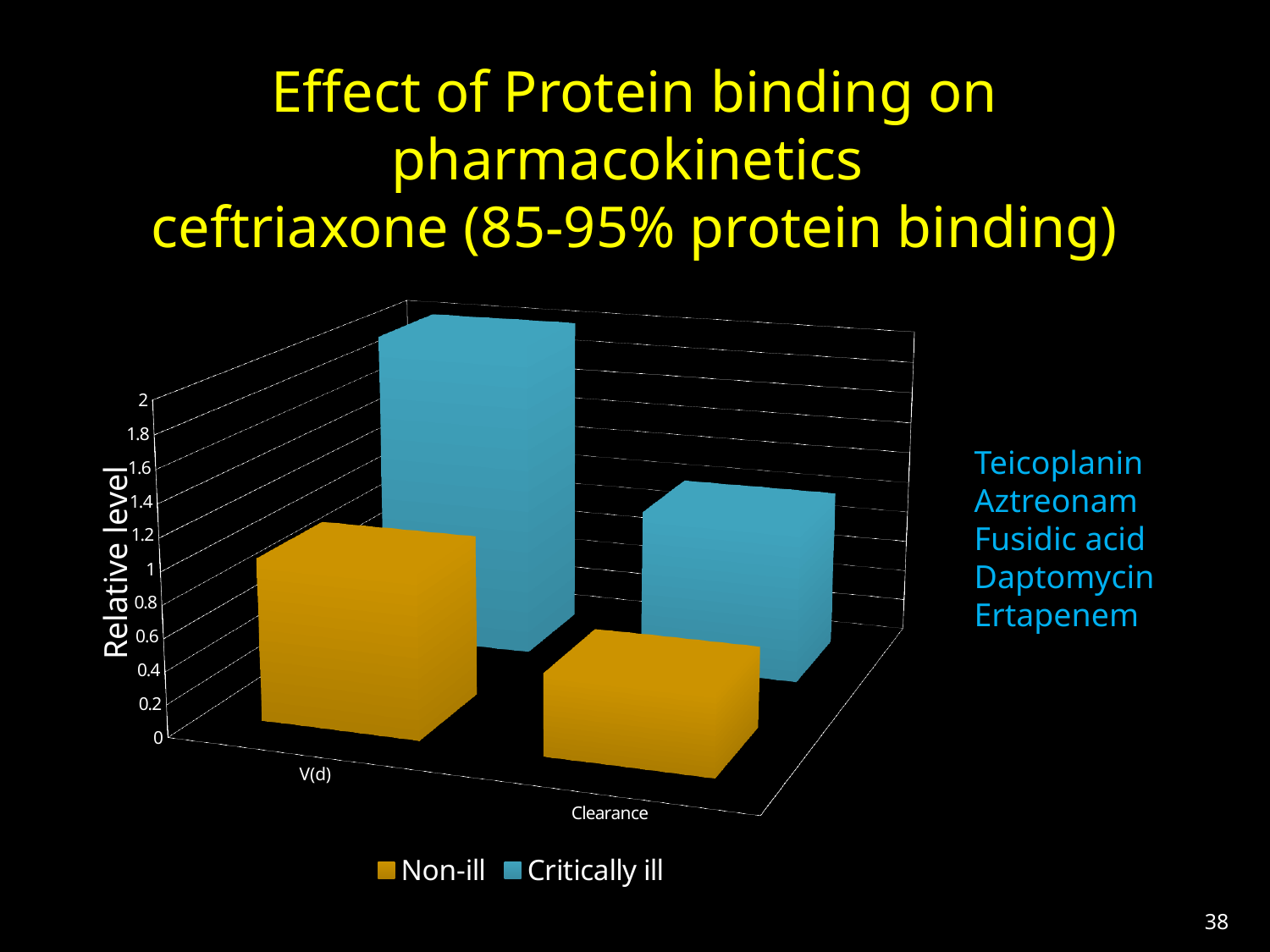
How many categories are shown on the x axis of the chart? 2 What kind of chart is shown on the slide? bar chart Which bar is the tallest in the chart? Critically ill, V(d) What is the title of the vertical axis of the chart? Relative level Is the Non-ill value for Clearance greater or less than 1? less Is the Non-ill value for V(d) greater or less than 1.6? less Is the Critically ill value for V(d) greater or less than 1.4? greater Which bar is the shortest in the chart? Non-ill, Clearance Which series is shown in blue in the chart legend? Critically ill How many series does the chart legend list? 2 For V(d), which series has the larger value, Non-ill or Critically ill? Critically ill For Clearance, which series has the larger value, Non-ill or Critically ill? Critically ill